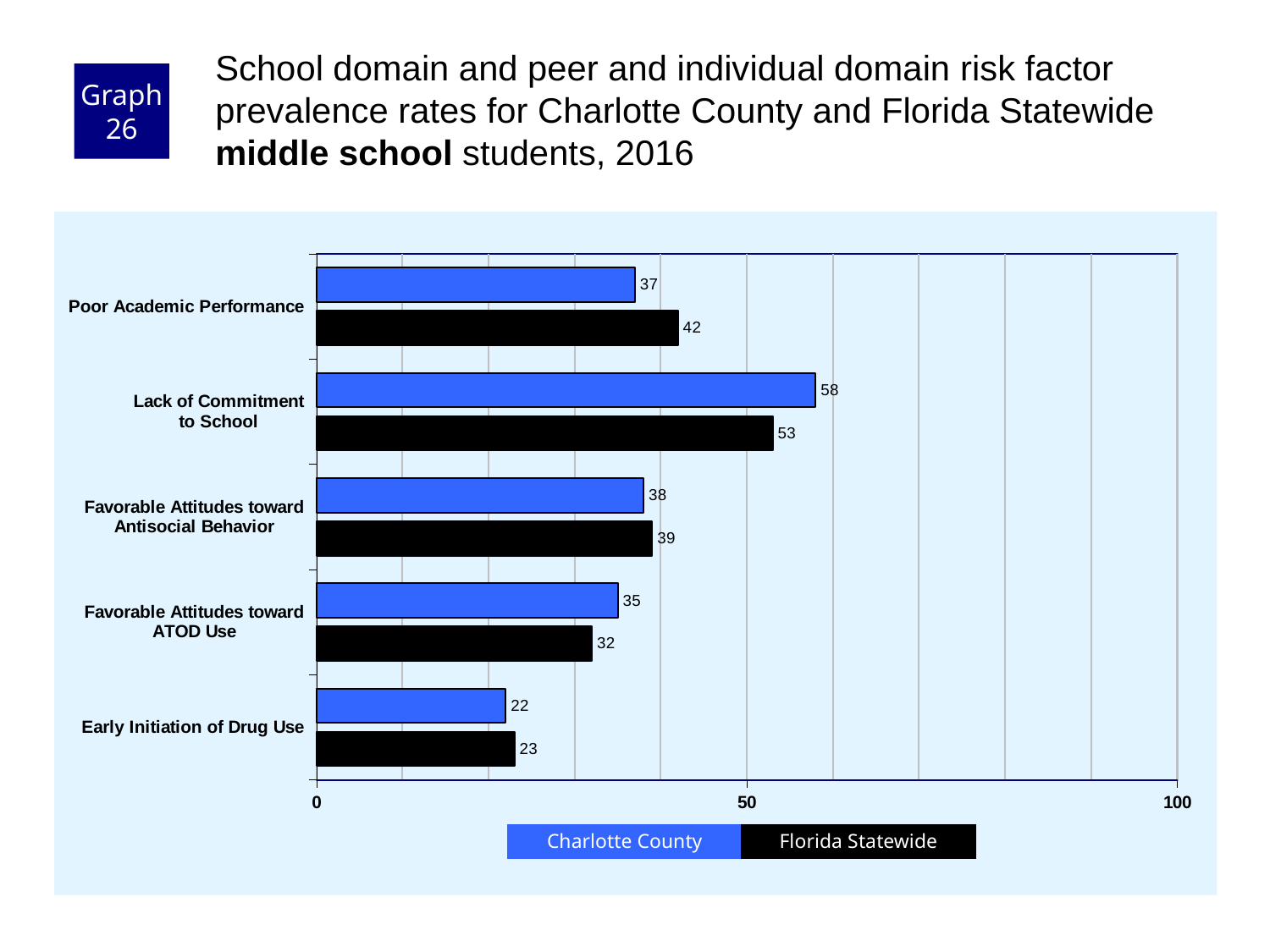
What is the Florida Statewide value for Poor Academic Performance? 42 Which risk factor has the lowest Florida Statewide value? Early Initiation of Drug Use For Favorable Attitudes toward ATOD Use, which is larger: Charlotte County or Florida Statewide? Charlotte County Which risk factor has the highest Charlotte County value? Lack of Commitment to School What is the Charlotte County value for Early Initiation of Drug Use? 22 What is the Charlotte County value for Lack of Commitment to School? 58 What is the difference between the Charlotte County and Florida Statewide values for Lack of Commitment to School? 5 What is the Florida Statewide value for Favorable Attitudes toward ATOD Use? 32 What is the difference between the Florida Statewide and Charlotte County values for Poor Academic Performance? 5 How many risk factor categories are shown on the chart? 5 How many series does the legend list? 2 What kind of chart is shown on the slide? Bar chart